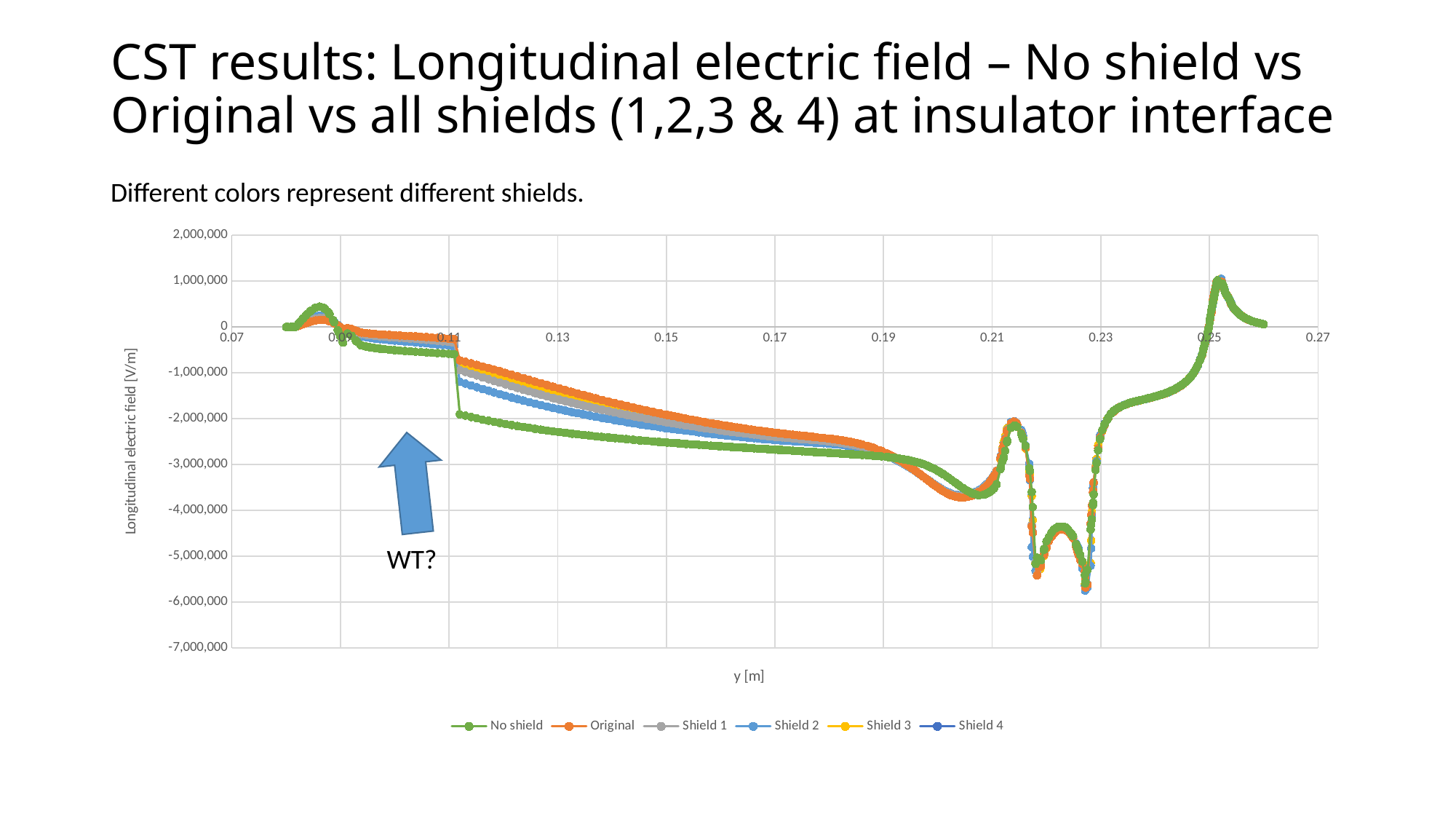
Is the lowest value of the curves, near y = 0.227, greater or less than -5,000,000? less Is the peak value of the curves near y = 0.25 greater or less than 0? greater Is the value of the No shield series at y = 0.13 greater or less than -1,000,000? less What is the label of the x axis? y [m] How many series does the legend list? 6 What kind of chart is shown on the slide? line chart At y = 0.15, which series has the higher value, No shield or Original? Original Between y = 0.13 and y = 0.19, do the values of the No shield series rise or fall? fall Between y = 0.23 and y = 0.25, do the values of the curves rise or fall? rise What are the series names listed in the legend? No shield, Original, Shield 1, Shield 2, Shield 3, Shield 4